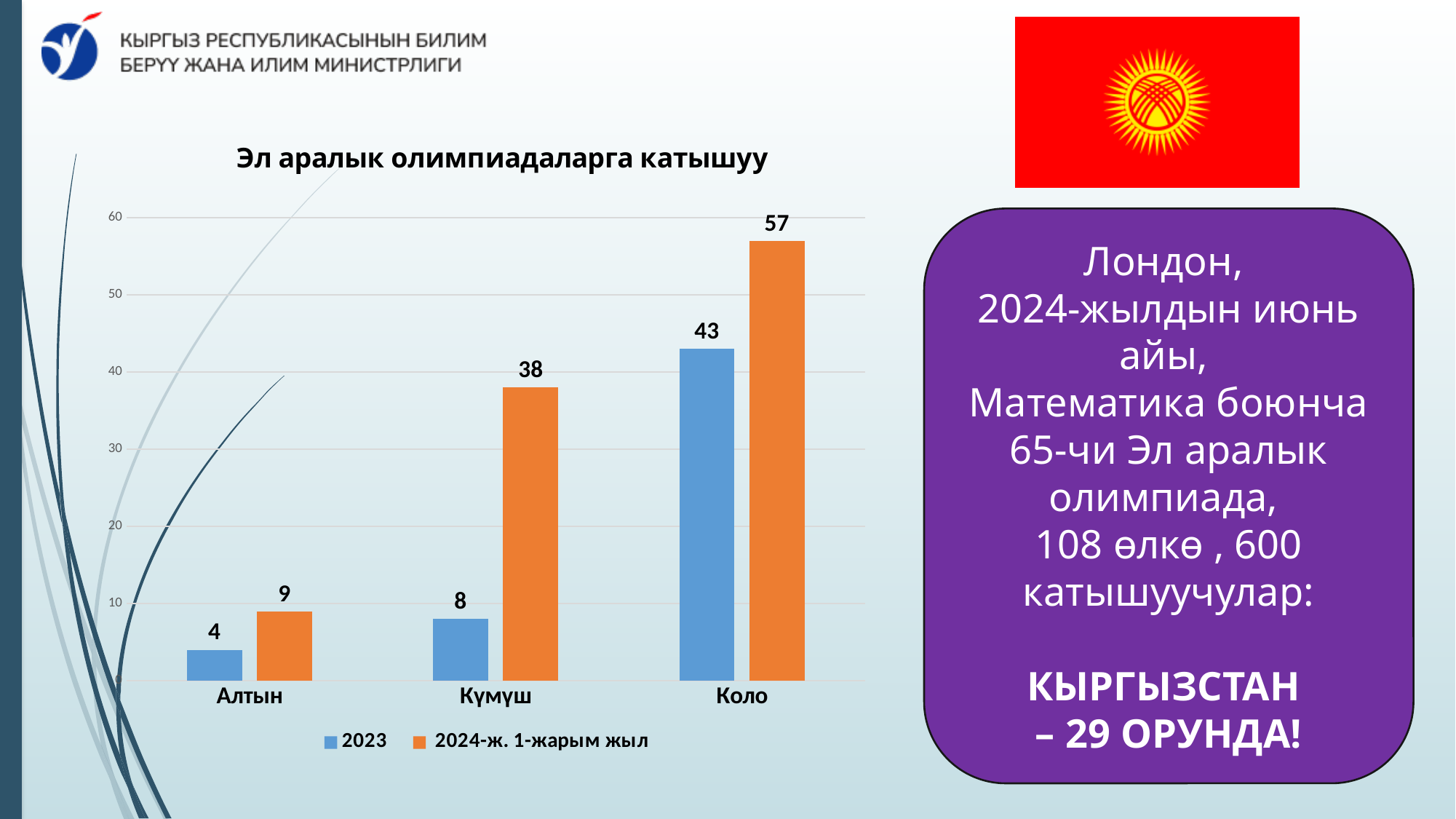
What is the difference between the 2024-ж. 1-жарым жыл and 2023 values for Күмүш? 30 Which is larger for Алтын: the 2023 value or the 2024-ж. 1-жарым жыл value? 2024-ж. 1-жарым жыл Which category has the highest value in the 2024-ж. 1-жарым жыл series? Коло What is the value for Алтын in the 2023 series? 4 How many series does the legend list? 2 What is the value for Коло in the 2023 series? 43 What is the difference between the 2024-ж. 1-жарым жыл and 2023 values for Коло? 14 How many categories are shown on the x axis? 3 What is the value for Күмүш in the 2024-ж. 1-жарым жыл series? 38 What kind of chart is shown on the slide? Bar chart What is the title of the chart? Эл аралык олимпиадаларга катышуу Which category has the lowest value in the 2023 series? Алтын